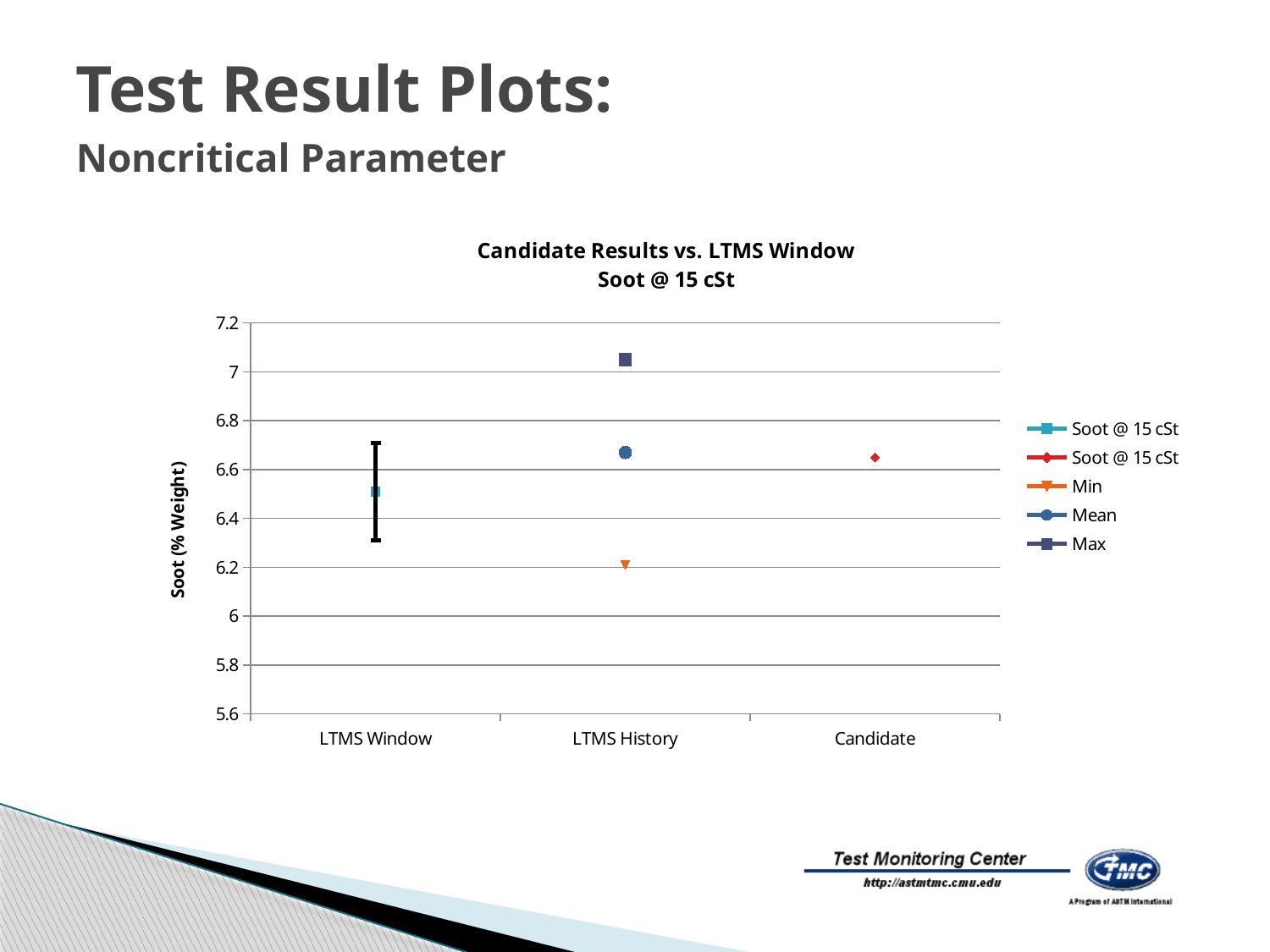
Which series at LTMS History has the lowest plotted value? Min Is the Candidate value greater or less than 6.8? less Is the Max value for LTMS History greater or less than 7.2? less How many series does the chart's legend list? 5 Is the Mean value for LTMS History greater or less than 6.6? greater How many categories are shown on the horizontal axis of the chart? 3 For LTMS History, which is larger, the Max value or the Min value? Max What is the label on the vertical axis of the chart? Soot (% Weight) What is the title of the chart? Candidate Results vs. LTMS Window Soot @ 15 cSt